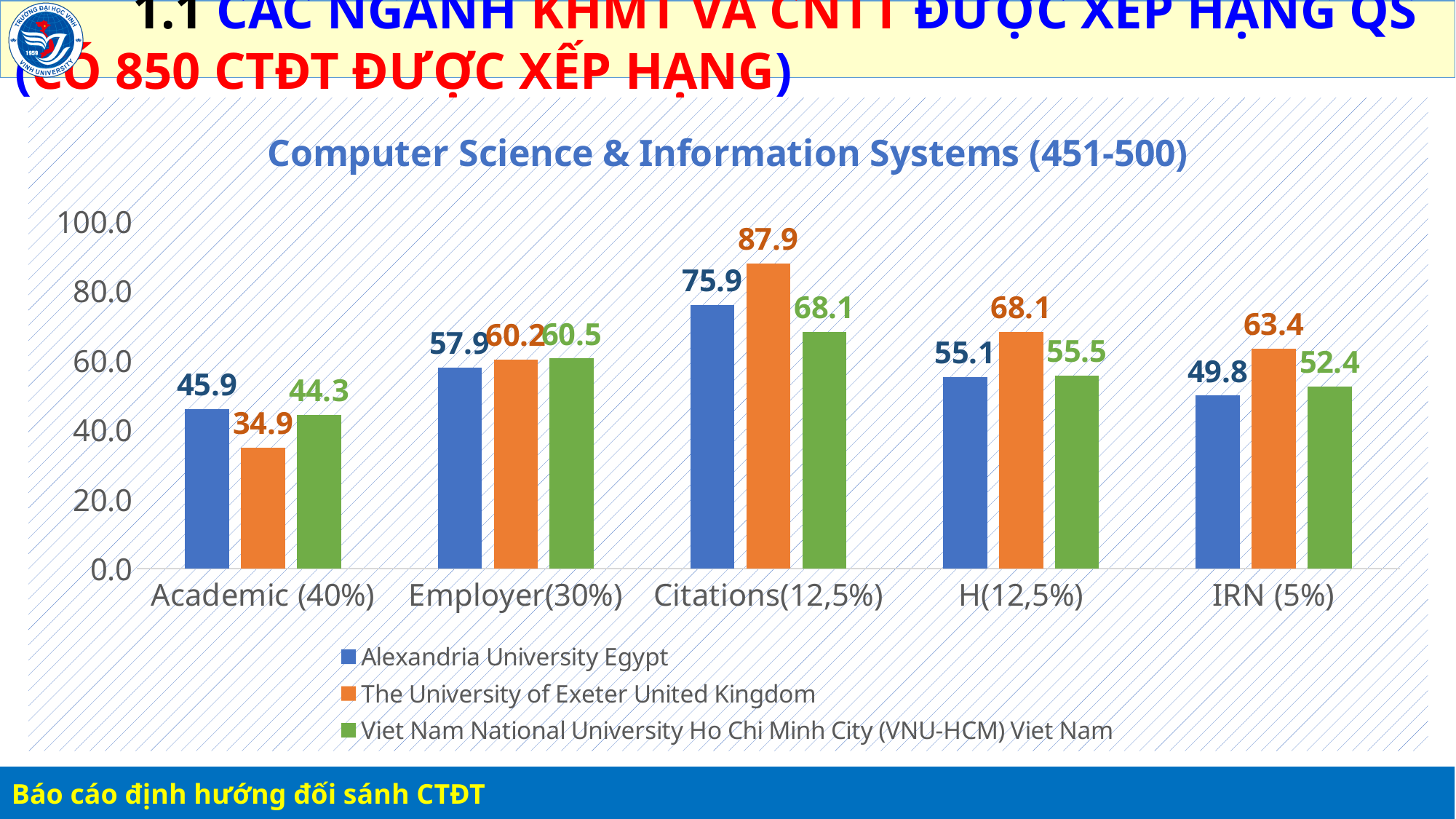
In which category does The University of Exeter United Kingdom have its highest value? Citations(12,5%) Is the value for The University of Exeter United Kingdom in the Citations(12,5%) category greater or less than 80.0? greater What is the difference between The University of Exeter United Kingdom and Alexandria University Egypt in the H(12,5%) category? 13.0 In the Academic (40%) category, which is larger: Alexandria University Egypt or The University of Exeter United Kingdom? Alexandria University Egypt How many categories are shown on the x axis? 5 What is the value for Alexandria University Egypt in the Academic (40%) category? 45.9 In which category does Alexandria University Egypt have its lowest value? Academic (40%) What is the value for The University of Exeter United Kingdom in the Citations(12,5%) category? 87.9 What kind of chart is shown on the slide? Bar chart What is the value for Viet Nam National University Ho Chi Minh City (VNU-HCM) Viet Nam in the IRN (5%) category? 52.4 How many series does the legend list? 3 What is the title of the chart? Computer Science & Information Systems (451-500)